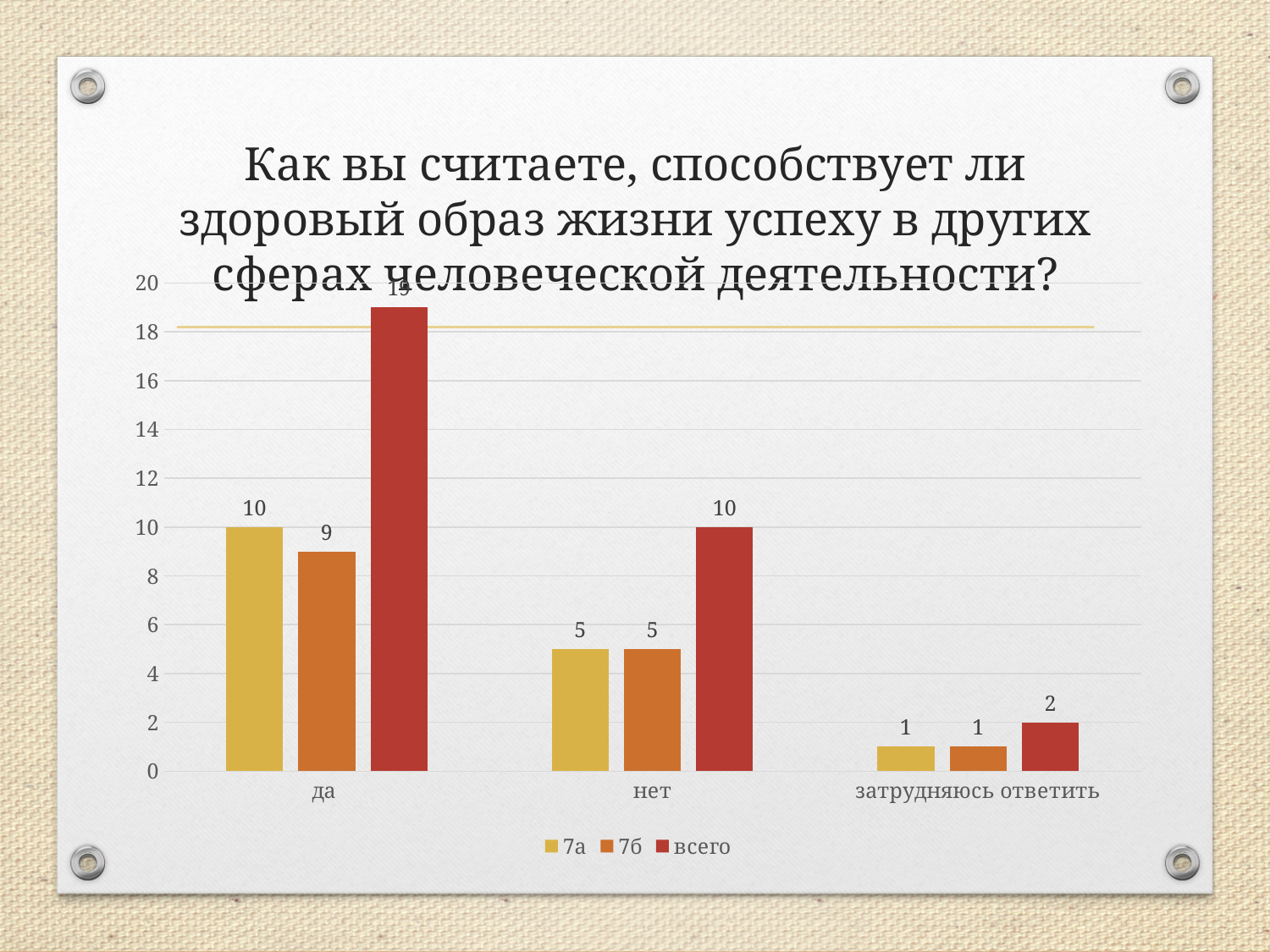
What is the value for "всего" in the category "нет"? 10 What is the value for 7а in the category "да"? 10 How many series does the legend list? 3 How many categories are shown on the x axis? 3 What is the value for 7б in the category "да"? 9 What kind of chart is shown on the slide? bar chart What is the difference between the 7а and 7б values in the category "да"? 1 What is the value for 7а in the category "затрудняюсь ответить"? 1 Is the value for "всего" in the category "да" greater or less than 18? greater Which category has the lowest value for the "всего" series? затрудняюсь ответить Which category has the highest value for the "всего" series? да In the category "да", which series has the larger value, 7а or 7б? 7а